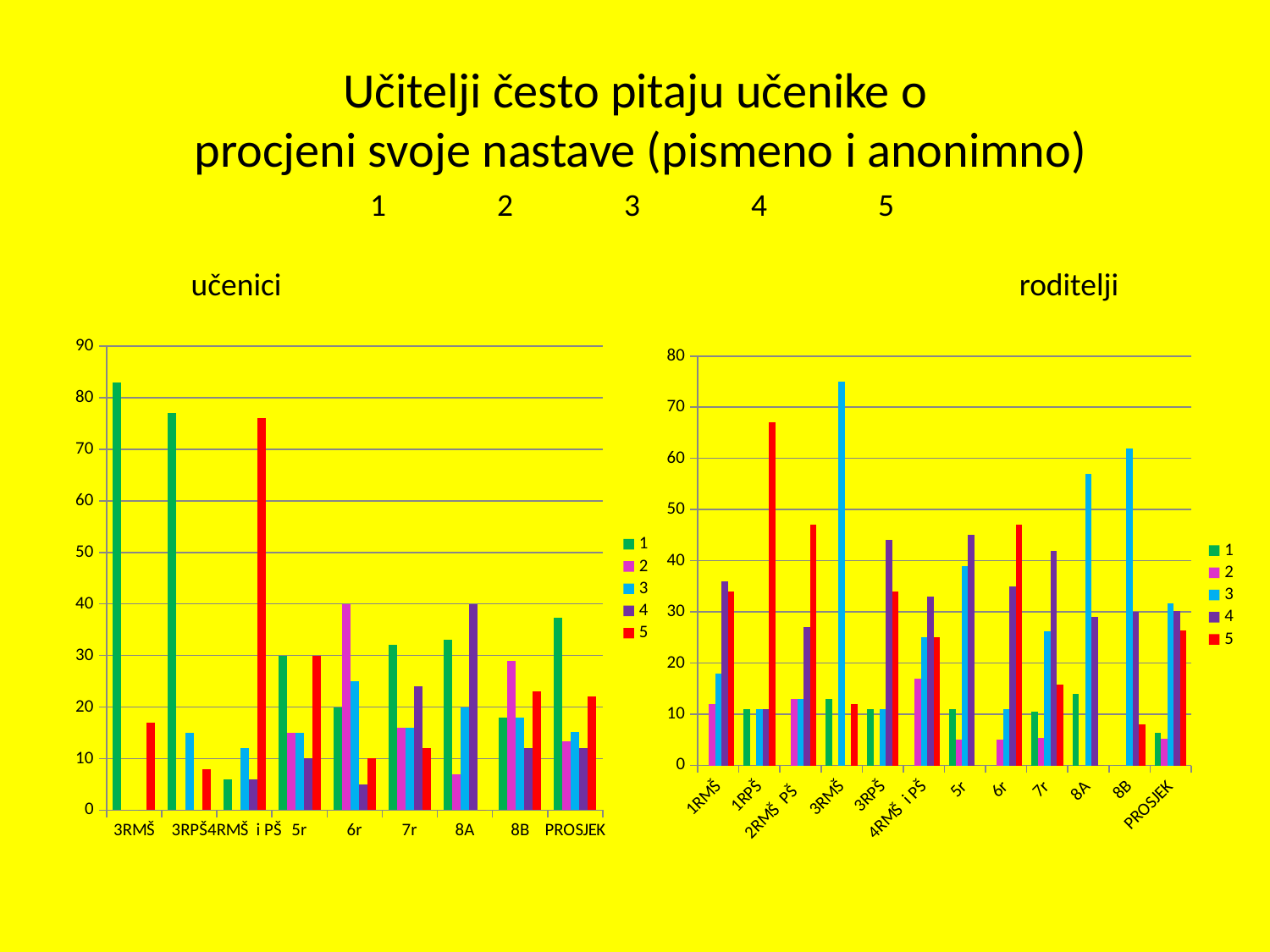
In the 'roditelji' chart on the right, which series has the tallest bar for 8B? 3 In the 'učenici' chart on the left, which category has the tallest bar overall? 3RMŠ In the 'učenici' chart on the left, is the value of series 5 for 4RMŠ i PŠ greater or less than 70? greater How many categories are shown on the x axis of the 'roditelji' chart on the right? 12 In the 'roditelji' chart on the right, is the value of series 3 for 3RMŠ greater or less than 70? greater In the 'roditelji' chart on the right, is the value of series 5 for 1RPŠ greater or less than 60? greater How many series does the legend of the 'roditelji' chart on the right list? 5 What kind of chart is the 'učenici' chart on the left? bar chart How many categories are shown on the x axis of the 'učenici' chart on the left? 9